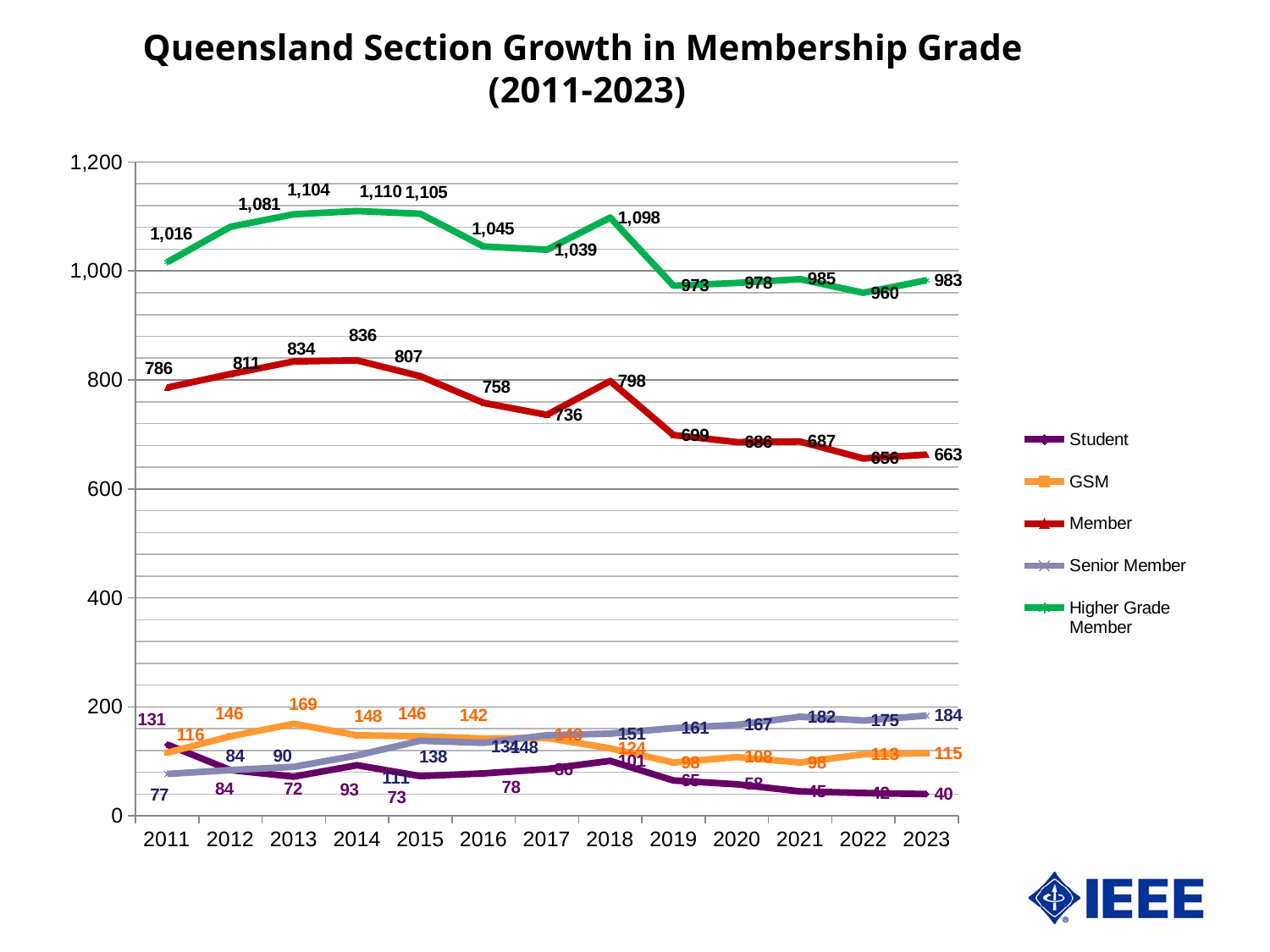
In which year is the Student series at its lowest? 2023 What is the GSM value for 2013? 169 How many series does the legend list? 5 What is the difference between the Member value in 2014 and in 2023? 173 Does the Student series rise or fall from 2018 to 2023? fall In which year is the Higher Grade Member series at its highest? 2014 What kind of chart is shown on the slide? line chart What is the Senior Member value for 2021? 182 In 2023, which is larger: the Senior Member value or the GSM value? Senior Member What is the Member value for 2011? 786 What is the Higher Grade Member value for 2014? 1,110 How many years are plotted along the x axis? 13